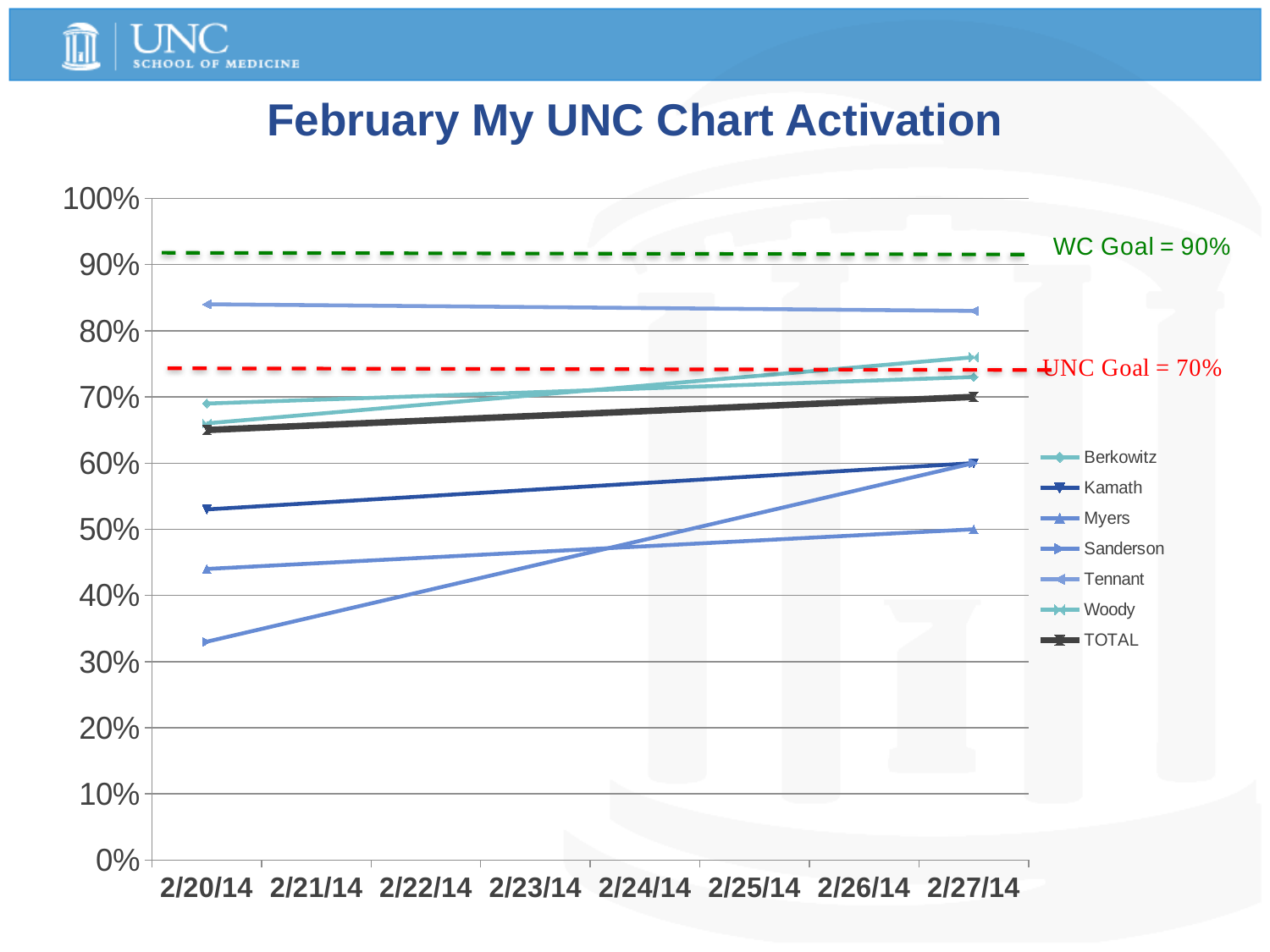
Which series has the lowest value on 2/20/14? Sanderson Is the value for Myers on 2/20/14 greater or less than 50%? less Is the value for Tennant on 2/27/14 greater or less than 80%? greater Is the value for Sanderson on 2/20/14 greater or less than 40%? less How many series does the legend list? 7 What kind of chart is shown on the slide? line chart What value is the WC Goal line set at? 90% How many dates are shown on the x axis? 8 Which series has the highest value on 2/20/14? Tennant Does the Sanderson line rise or fall from 2/20/14 to 2/27/14? rise Which is larger on 2/20/14, the value for Kamath or the value for Myers? Kamath